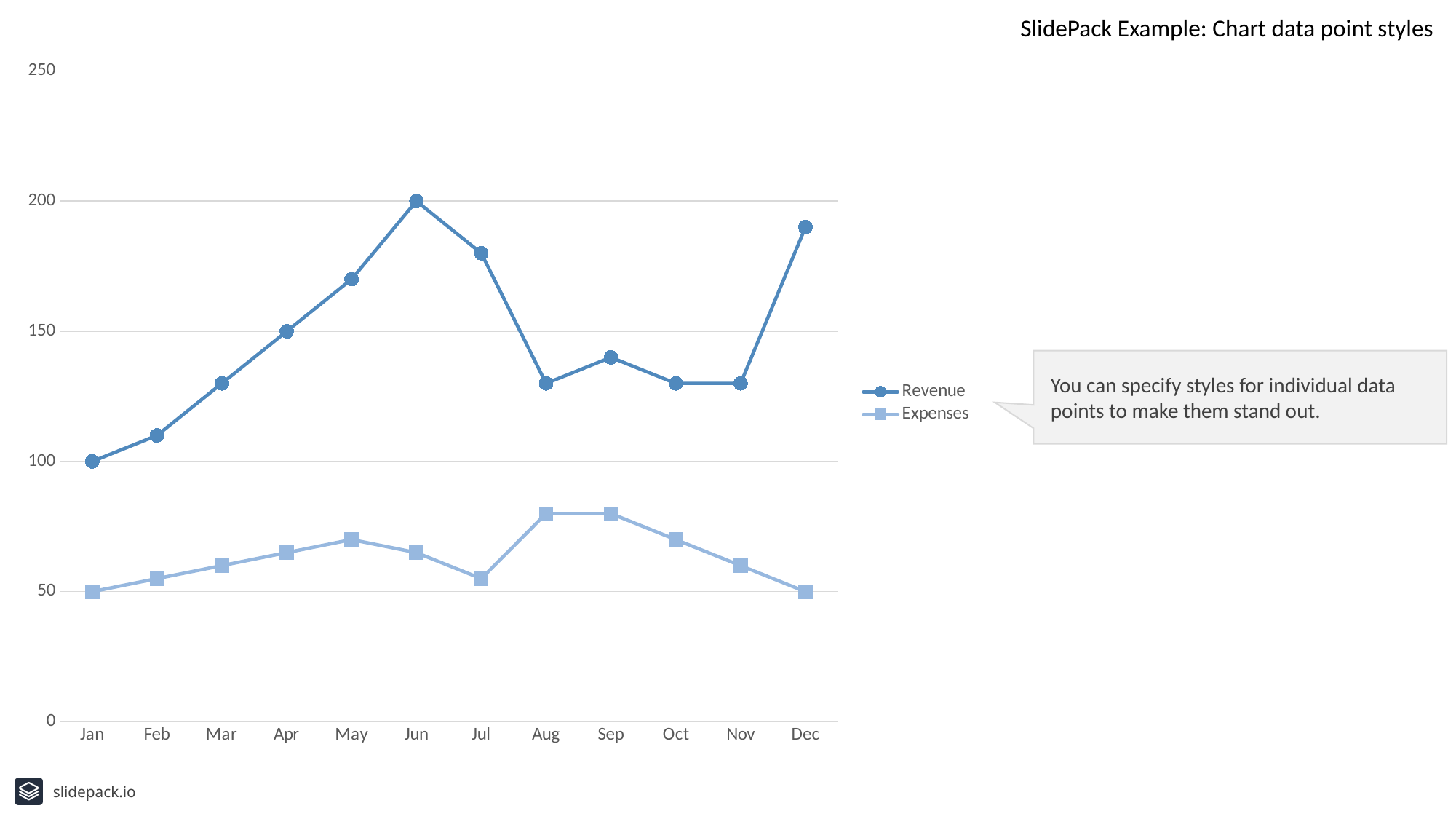
What is the Revenue value for Jan? 100 Is the Revenue value for Dec greater or less than 150? greater How many months are plotted along the x axis? 12 What is the Expenses value for Jan? 50 In which month is Revenue lowest? Jan In which month is Revenue highest? Jun What is the difference between Revenue in Jun and Revenue in Jan? 100 How many series does the legend list? 2 Does Revenue rise or fall from Jan to Jun? Rise What is the Revenue value for Jun? 200 What type of chart is shown on the slide? Line chart Is the Expenses value for Aug greater or less than 100? less